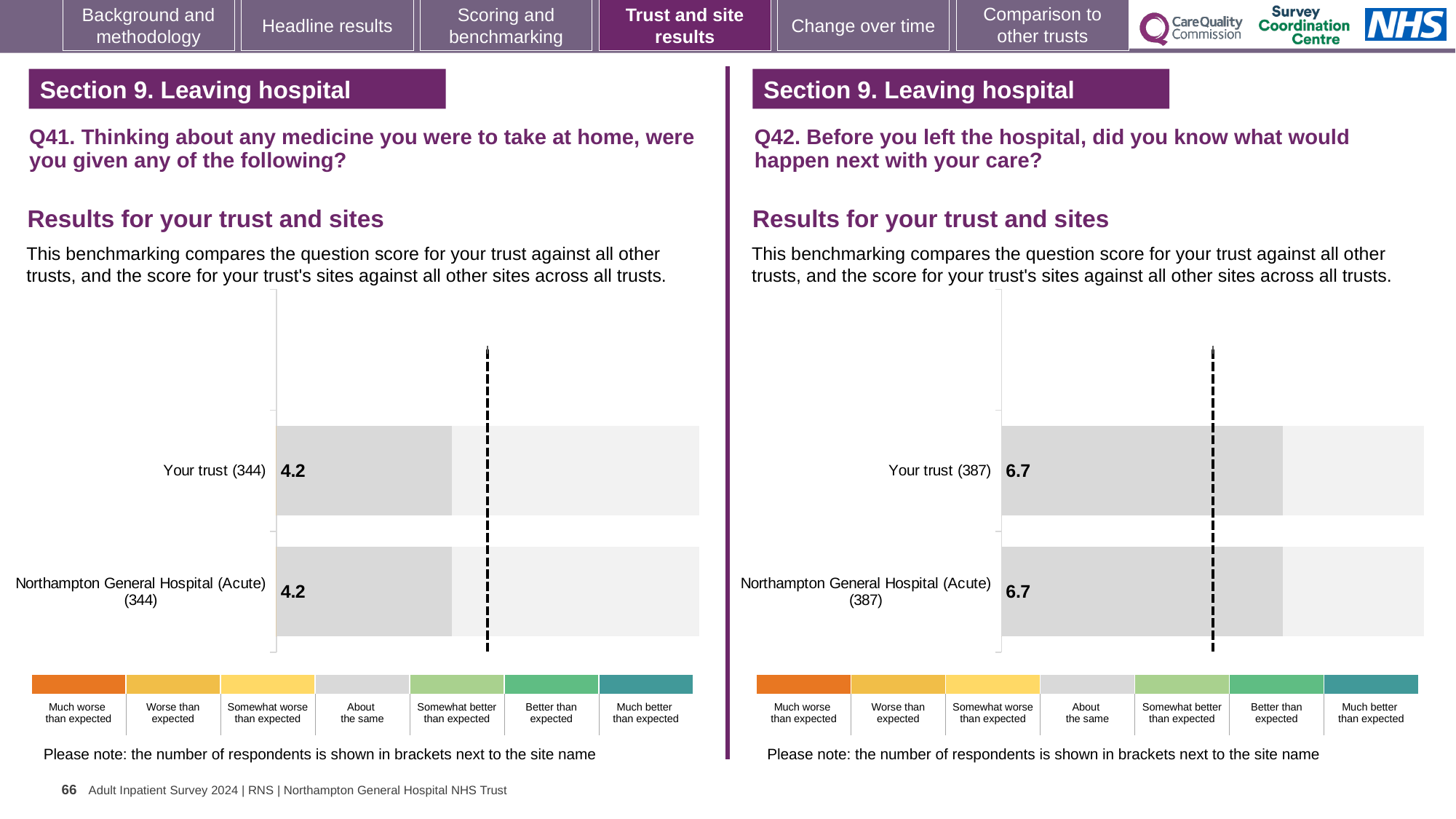
On the Q42 chart (right), what is the score for Your trust? 6.7 Is the score for Your trust on the Q42 chart (right) larger than the score for Your trust on the Q41 chart (left)? Yes How many bars are plotted on the Q42 chart (right)? 2 On the Q42 chart (right), how many respondents are shown in brackets for Northampton General Hospital (Acute)? 387 On the Q41 chart (left), what is the difference between the score for Your trust and the score for Northampton General Hospital (Acute)? 0 On the Q41 chart (left), what is the score for Northampton General Hospital (Acute)? 4.2 On the Q41 chart (left), what is the score for Your trust? 4.2 On the Q41 chart (left), how many respondents are shown in brackets for Your trust? 344 On the Q42 chart (right), what is the score for Northampton General Hospital (Acute)? 6.7 On the Q42 chart (right), what is the difference between the score for Your trust and the score for Northampton General Hospital (Acute)? 0 What kind of chart is used on the Q42 chart (right)? Bar chart How many bars are plotted on the Q41 chart (left)? 2